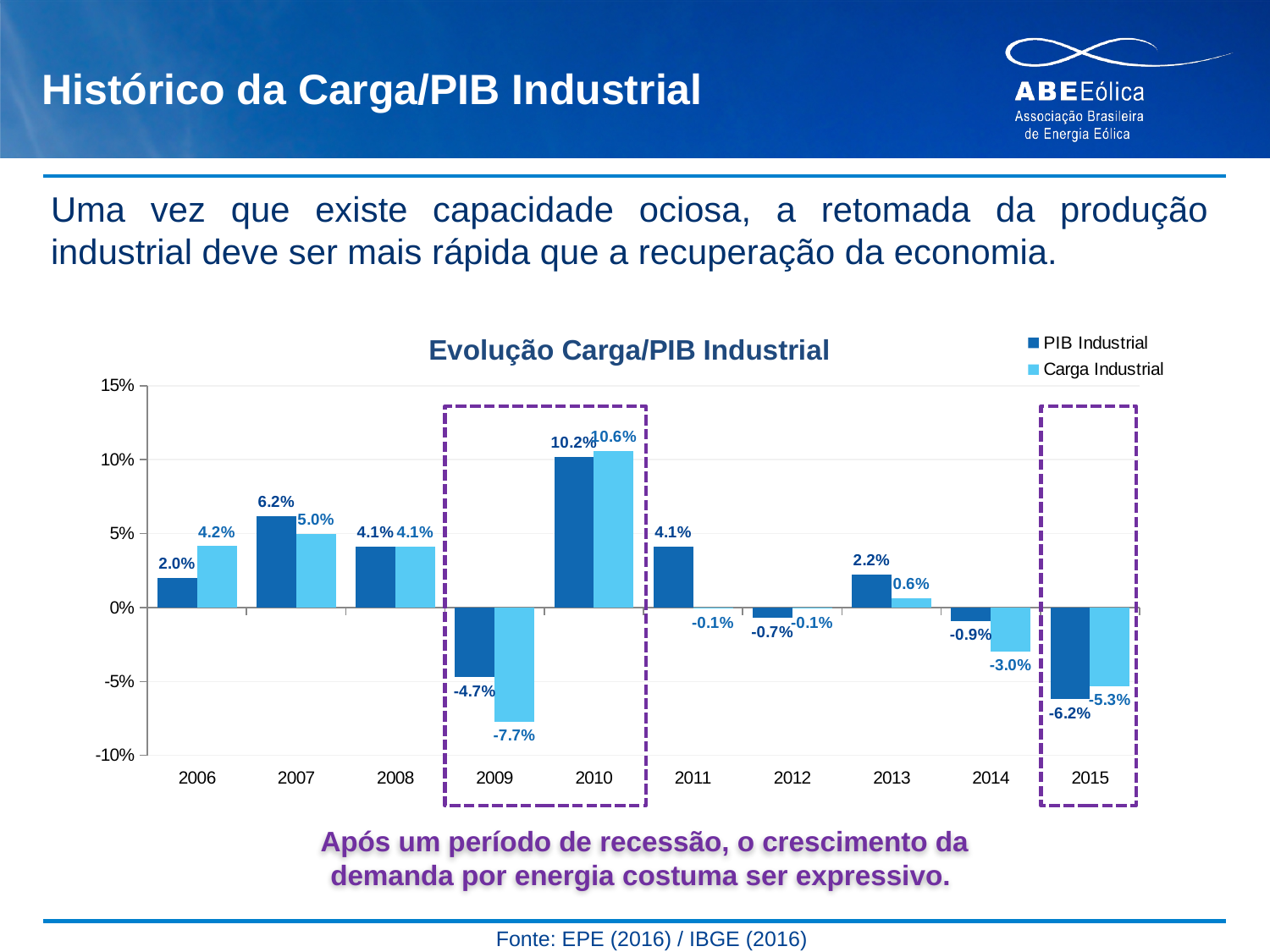
Is the value of Carga Industrial in 2010 greater or less than 10%? greater What is the difference between Carga Industrial and PIB Industrial in 2009? 3.0% What type of chart is shown? Bar chart What is the value of Carga Industrial in 2009? -7.7% How many years are shown on the x axis? 10 What is the value of PIB Industrial in 2010? 10.2% In which year is Carga Industrial highest? 2010 How many series does the legend list? 2 What is the value of Carga Industrial in 2014? -3.0% In which year is PIB Industrial lowest? 2015 What is the value of PIB Industrial in 2015? -6.2% Which is larger in 2011, PIB Industrial or Carga Industrial? PIB Industrial